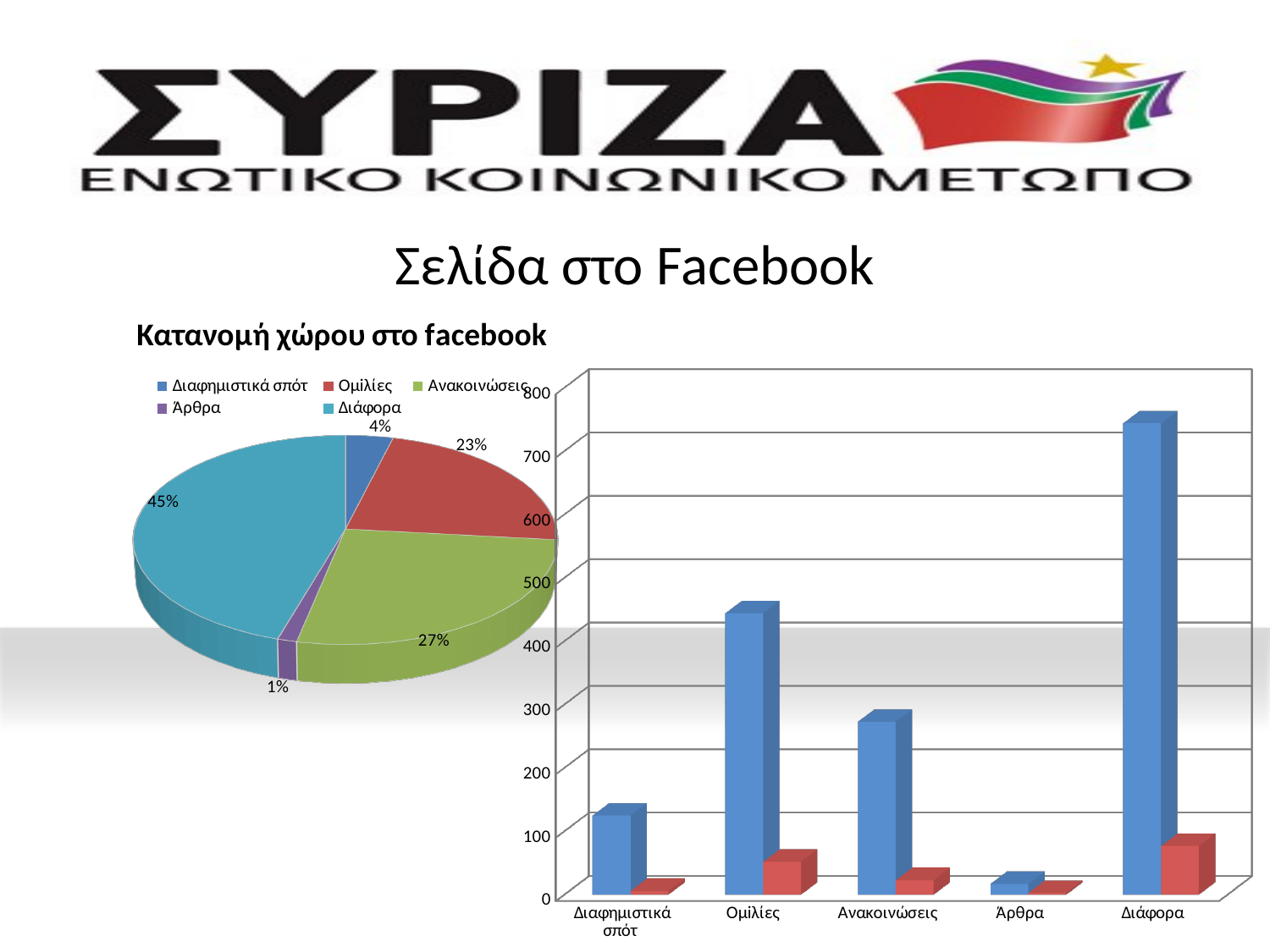
In the pie chart "Κατανομή χώρου στο facebook", which category has the smallest slice? Άρθρα How many categories does the legend of the pie chart "Κατανομή χώρου στο facebook" list? 5 In the pie chart "Κατανομή χώρου στο facebook", what is the difference between the shares of Ανακοινώσεις and Ομιλίες? 4% In the pie chart "Κατανομή χώρου στο facebook", which category has the largest slice? Διάφορα What kind of chart is the chart titled "Κατανομή χώρου στο facebook"? pie chart In the pie chart "Κατανομή χώρου στο facebook", what share does Ομιλίες have? 23% What kind of chart is the chart on the right side of the slide? bar chart In the pie chart "Κατανομή χώρου στο facebook", what share does Διάφορα have? 45% In the bar chart on the right, which category has the tallest blue bar? Διάφορα In the pie chart "Κατανομή χώρου στο facebook", what share does Άρθρα have? 1% In the bar chart on the right, is the blue bar for Ανακοινώσεις greater or less than 300? less In the bar chart on the right, is the blue bar for Ομιλίες greater or less than 400? greater